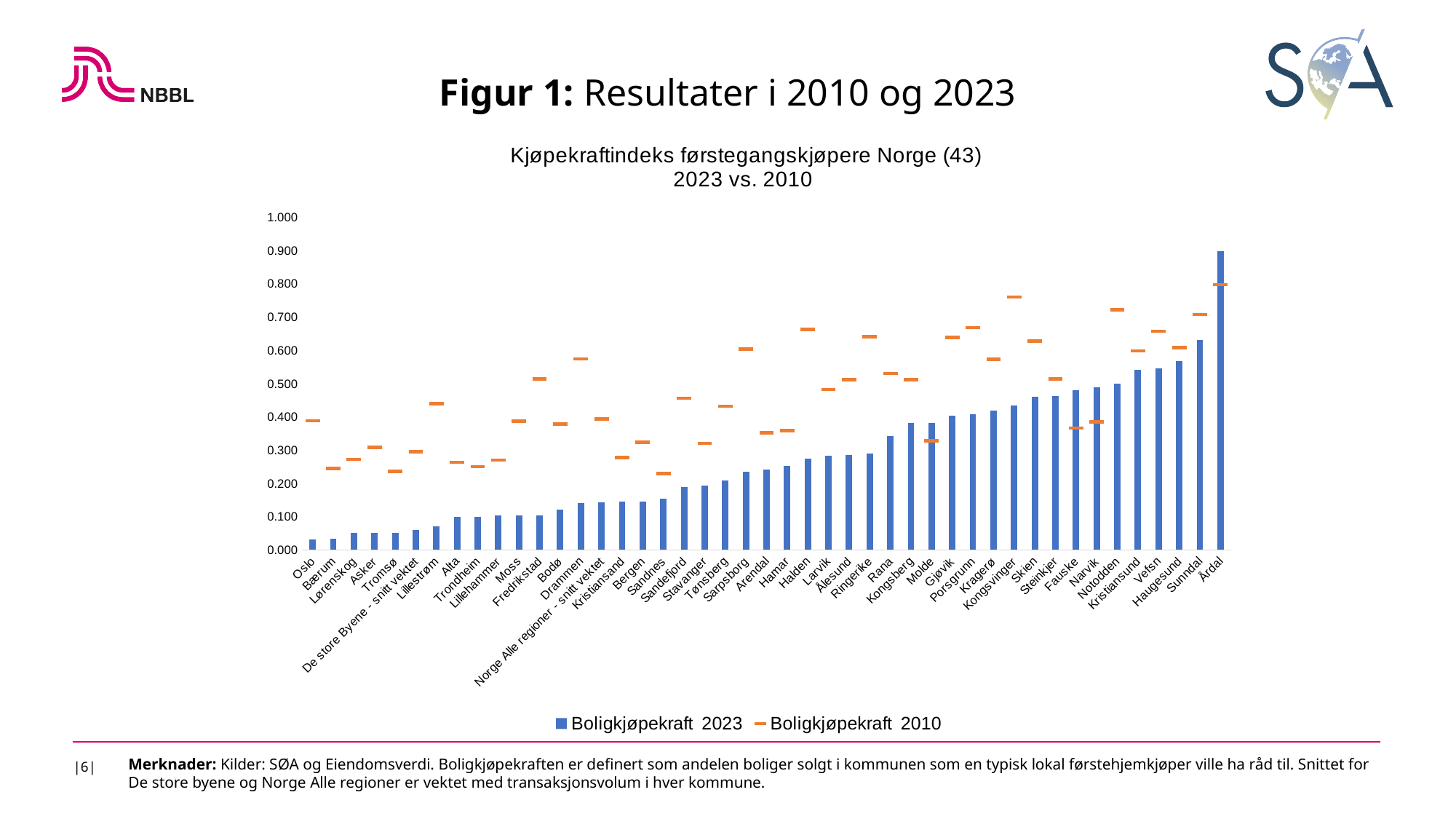
How many series does the legend list? 2 Which is larger: the Boligkjøpekraft 2023 value for Sunndal or for Bergen? Sunndal Which category has the lowest Boligkjøpekraft 2023 value? Oslo Do the Boligkjøpekraft 2023 bars rise or fall from left to right along the x axis? rise Is the Boligkjøpekraft 2023 value for Oslo greater or less than 0.100? less Is the Boligkjøpekraft 2010 value for Bærum greater or less than 0.300? less For Oslo, which is larger: the Boligkjøpekraft 2010 value or the Boligkjøpekraft 2023 value? Boligkjøpekraft 2010 Is the Boligkjøpekraft 2023 value for Årdal greater or less than 0.800? greater What kind of chart is shown on the slide? Bar chart What are the two legend entries of the chart? Boligkjøpekraft 2023 and Boligkjøpekraft 2010 Which category has the highest Boligkjøpekraft 2023 value? Årdal